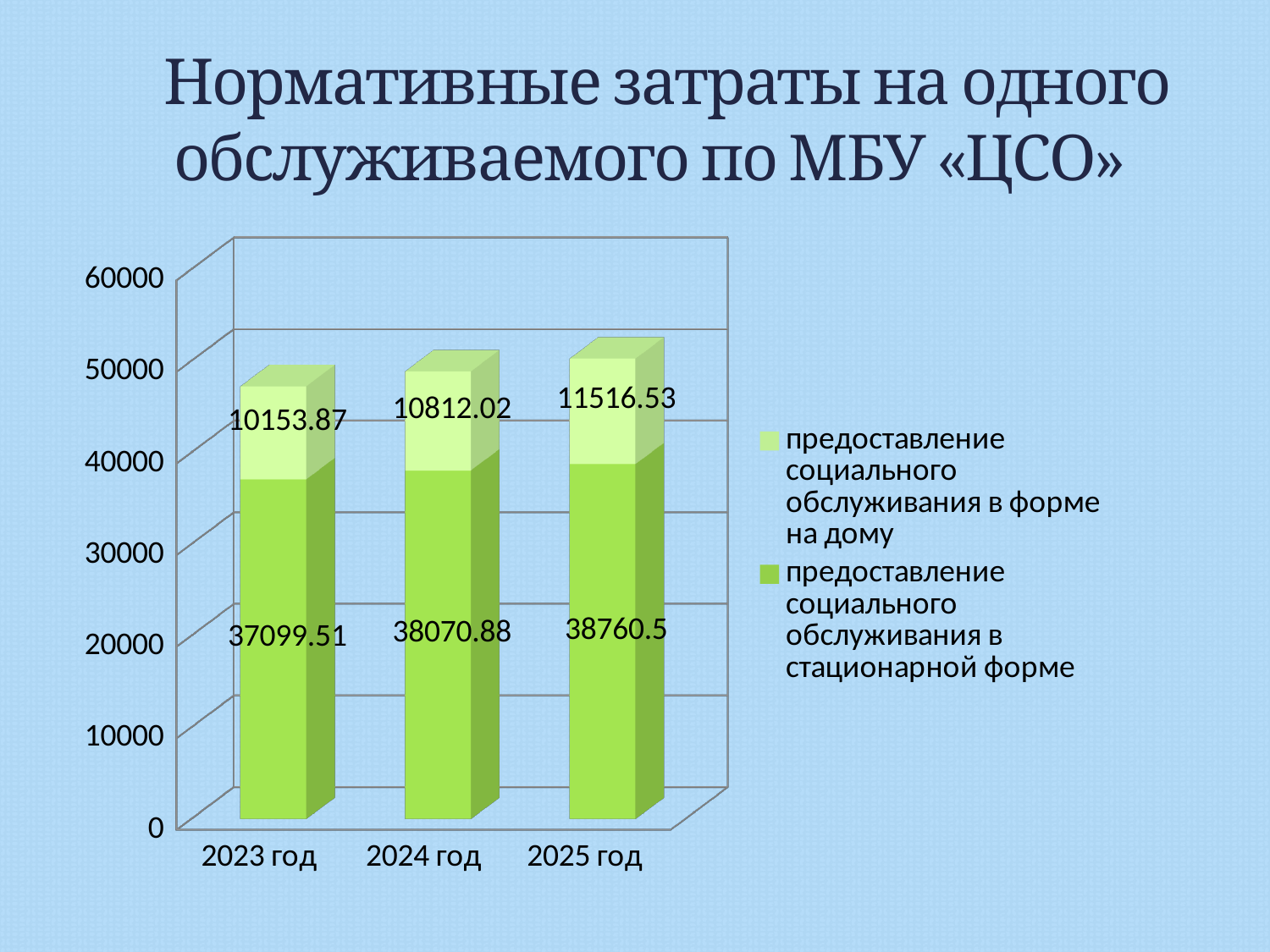
How many years are shown on the x axis? 3 Which year has the lowest value for 'предоставление социального обслуживания в форме на дому'? 2023 год Is the total of the stacked bar for 2025 год greater or less than 50000? greater Which is larger: the 'предоставление социального обслуживания в стационарной форме' value for 2024 год or for 2023 год? 2024 год How many series does the legend list? 2 What is the total of the stacked bar for 2023 год? 47253.38 What is the value for 'предоставление социального обслуживания в стационарной форме' in 2023 год? 37099.51 What is the value for 'предоставление социального обслуживания в форме на дому' in 2024 год? 10812.02 What is the value for 'предоставление социального обслуживания в форме на дому' in 2025 год? 11516.53 Which year has the highest value for 'предоставление социального обслуживания в стационарной форме'? 2025 год What is the difference between the 'предоставление социального обслуживания в форме на дому' values for 2025 год and 2023 год? 1362.66 What kind of chart is shown on the slide? Stacked bar chart